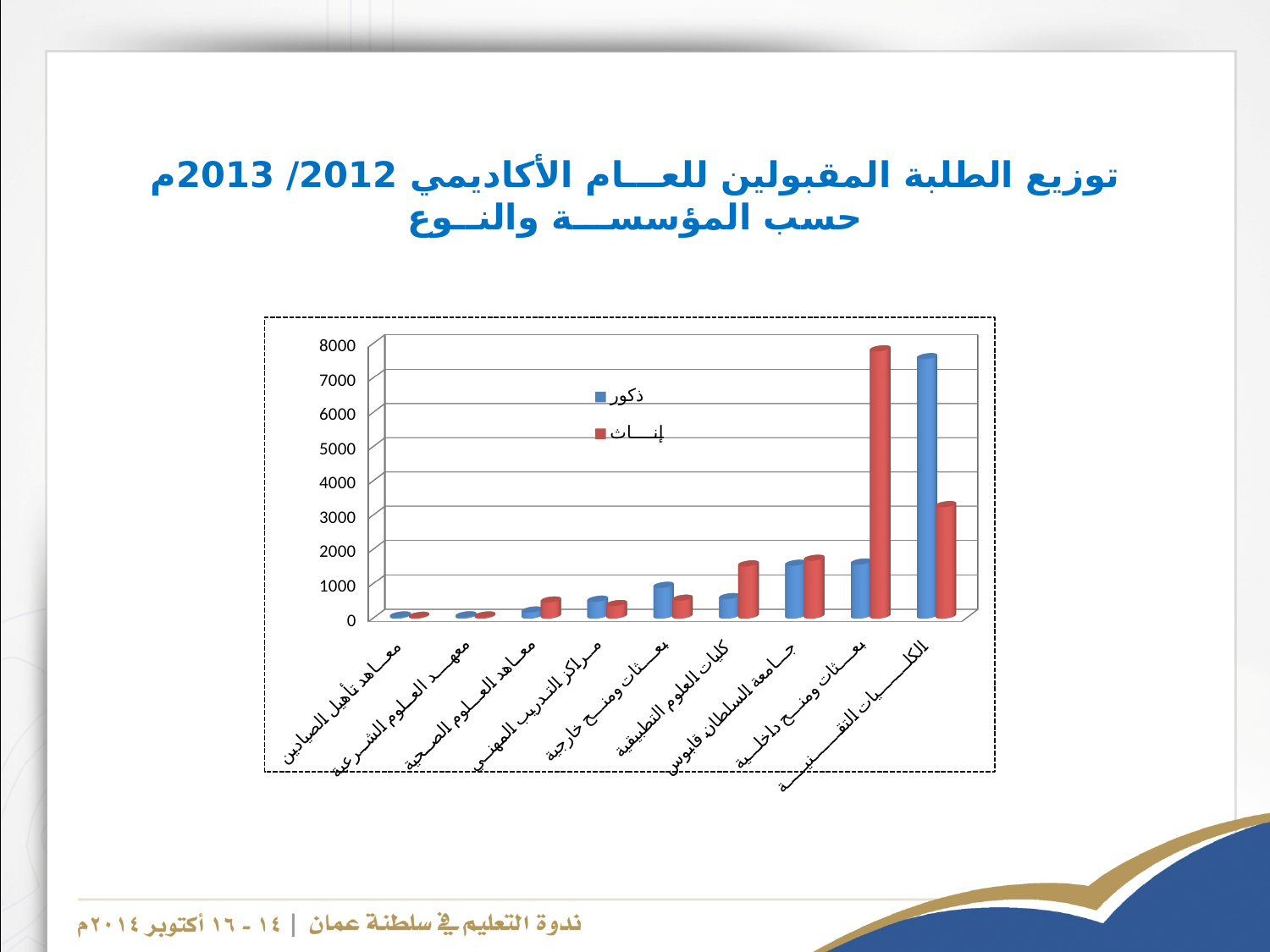
For بعثات ومنح داخلية, which series has the larger value, ذكور or إناث? إناث What kind of chart is shown on the slide? bar chart How many institution categories are shown on the x axis of the chart? 9 Is the ذكور value for كليات العلوم التطبيقية greater or less than 1000? less Which category has the highest value for the ذكور series? الكليات التقنية For الكليات التقنية, which series has the larger value, ذكور or إناث? ذكور Is the إناث value for بعثات ومنح داخلية greater or less than 7000? greater Which colour represents the ذكور series in the chart? blue How many series does the chart legend list? 2 Which category has the highest value for the إناث series? بعثات ومنح داخلية Is the ذكور value for الكليات التقنية greater or less than 7000? greater